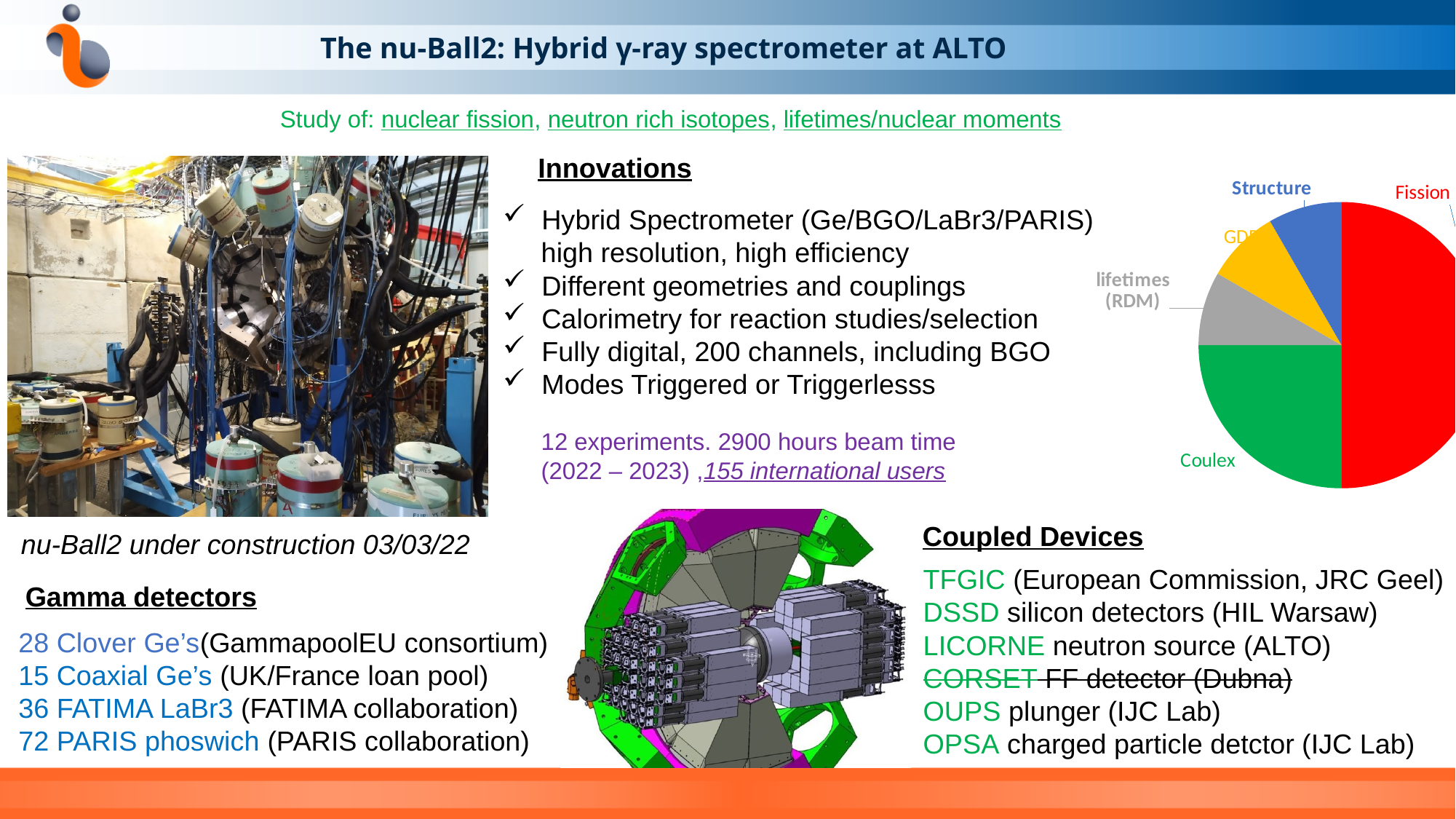
In the pie chart, which is larger: Coulex or lifetimes (RDM)? Coulex In the pie chart, which is larger: Fission or Structure? Fission What colour is the Fission slice in the pie chart? red What colour is the Coulex slice in the pie chart? green In the pie chart, which is larger: Fission or Coulex? Fission How many slices does the pie chart have? 5 What kind of chart is shown on the right side of the slide? pie chart Which category has the largest slice in the pie chart? Fission